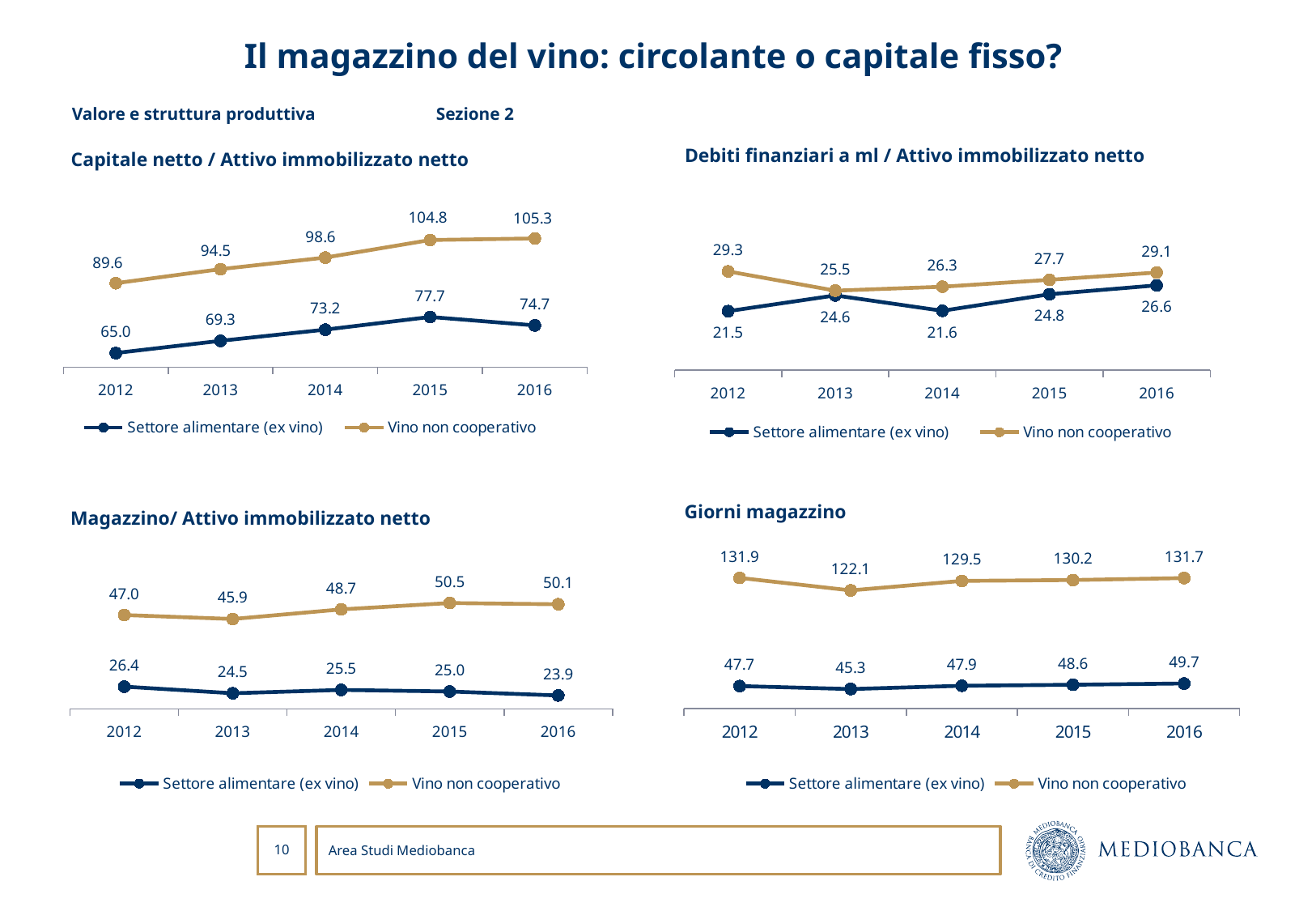
What type of chart is the 'Magazzino/ Attivo immobilizzato netto' chart? Line chart In the 'Capitale netto / Attivo immobilizzato netto' chart, what is the value for Vino non cooperativo in 2015? 104.8 In the 'Debiti finanziari a ml / Attivo immobilizzato netto' chart, which series has the larger value in 2016? Vino non cooperativo How many years are shown on the x axis of the 'Giorni magazzino' chart? 5 In the 'Giorni magazzino' chart, what is the value for Vino non cooperativo in 2012? 131.9 In the 'Debiti finanziari a ml / Attivo immobilizzato netto' chart, in which year is the Vino non cooperativo value lowest? 2013 In the 'Giorni magazzino' chart, what is the difference between Vino non cooperativo and Settore alimentare (ex vino) in 2016? 82.0 In the 'Capitale netto / Attivo immobilizzato netto' chart, in which year is the Settore alimentare (ex vino) value highest? 2015 In the 'Magazzino/ Attivo immobilizzato netto' chart, in which year is the Settore alimentare (ex vino) value lowest? 2016 In the 'Magazzino/ Attivo immobilizzato netto' chart, what is the value for Vino non cooperativo in 2013? 45.9 In the 'Capitale netto / Attivo immobilizzato netto' chart, what is the difference between Vino non cooperativo and Settore alimentare (ex vino) in 2012? 24.6 In the 'Debiti finanziari a ml / Attivo immobilizzato netto' chart, what is the value for Settore alimentare (ex vino) in 2014? 21.6